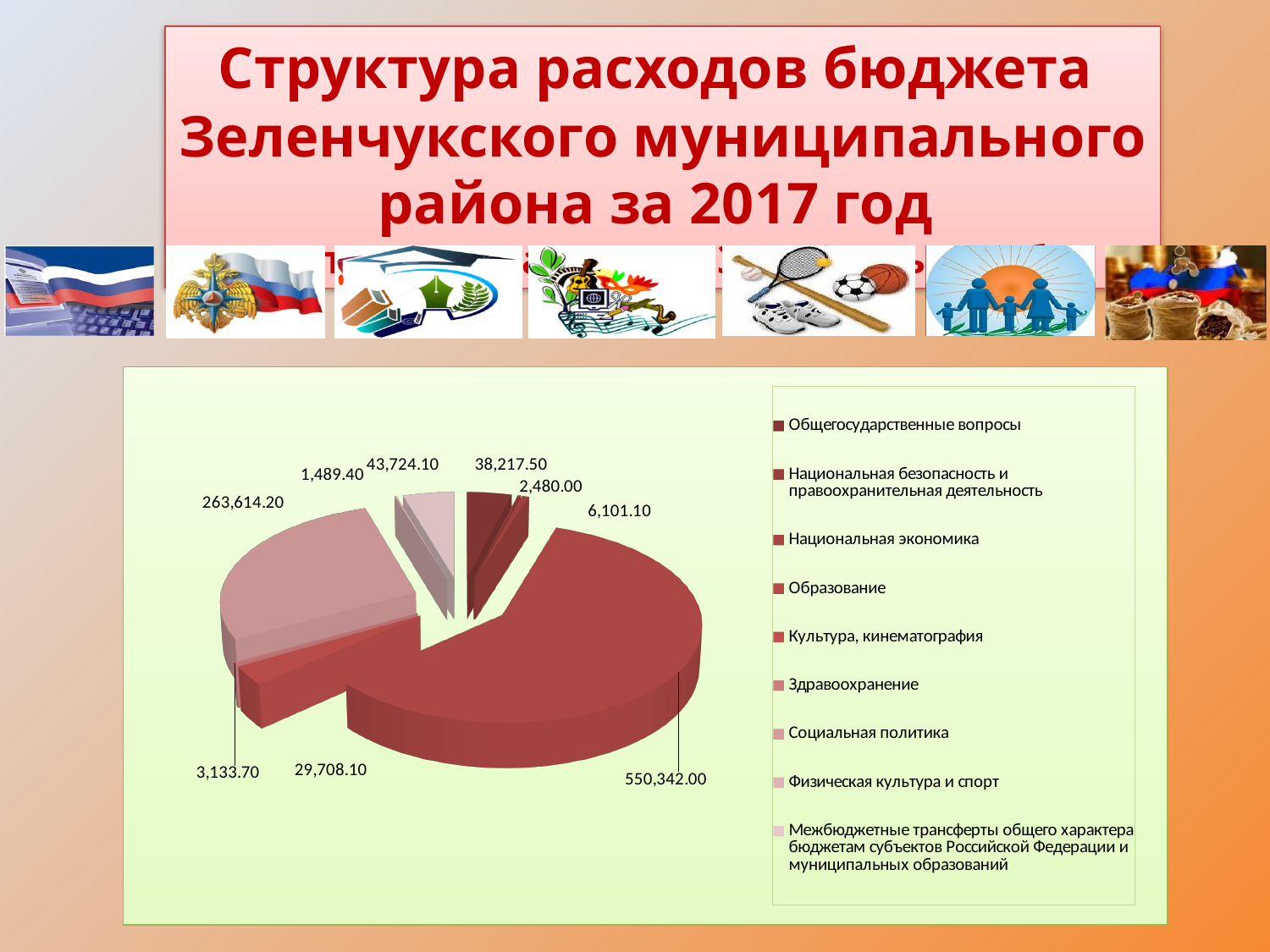
Which legend entry is listed last in the pie chart's legend? Межбюджетные трансферты общего характера бюджетам субъектов Российской Федерации и муниципальных образований What is the difference between the two largest labelled values, 550,342.00 and 263,614.20? 286,727.80 What kind of chart is shown on the slide? pie chart What is the value of the second-largest slice, Социальная политика? 263,614.20 How many categories does the legend of the pie chart list? 9 What is the largest value labelled on the pie chart? 550,342.00 How many slices does the pie chart have? 9 What is the value of the largest slice, which corresponds to Образование? 550,342.00 Which labelled value is larger: 43,724.10 or 38,217.50? 43,724.10 What year does the slide title say the budget expenditure structure refers to? 2017 What is the difference between the labelled values 29,708.10 and 3,133.70? 26,574.40 What is the smallest value labelled on the pie chart? 1,489.40